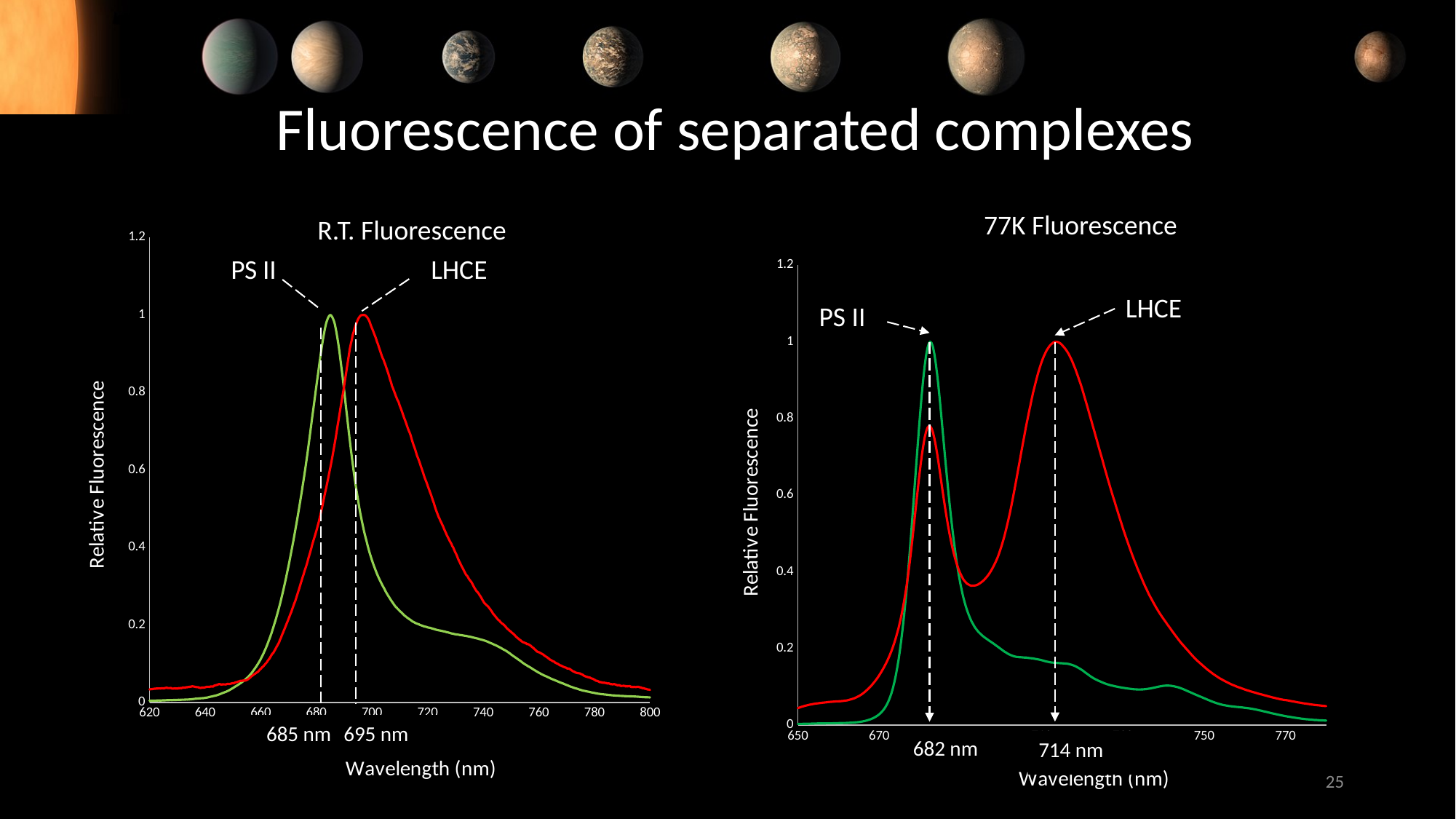
In the R.T. Fluorescence chart, at what wavelength does the LHCE curve peak? 695 nm In the 77K Fluorescence chart, which curve peaks at the longer wavelength, PS II or LHCE? LHCE In the 77K Fluorescence chart, at what wavelength does the LHCE curve peak? 714 nm What is the y-axis label on the 77K Fluorescence chart? Relative Fluorescence How many curves are plotted on the 77K Fluorescence chart? 2 In the 77K Fluorescence chart, is the LHCE value at 682 nm greater or less than 0.6? greater In the R.T. Fluorescence chart, at what wavelength does the PS II curve peak? 685 nm In the 77K Fluorescence chart, at what wavelength does the PS II curve peak? 682 nm In the R.T. Fluorescence chart, what is the difference in wavelength between the LHCE peak and the PS II peak? 10 nm In the R.T. Fluorescence chart, is the PS II value at 740 nm greater or less than 0.4? less In the 77K Fluorescence chart, what is the difference in wavelength between the LHCE peak and the PS II peak? 32 nm What kind of chart is the R.T. Fluorescence chart? line chart